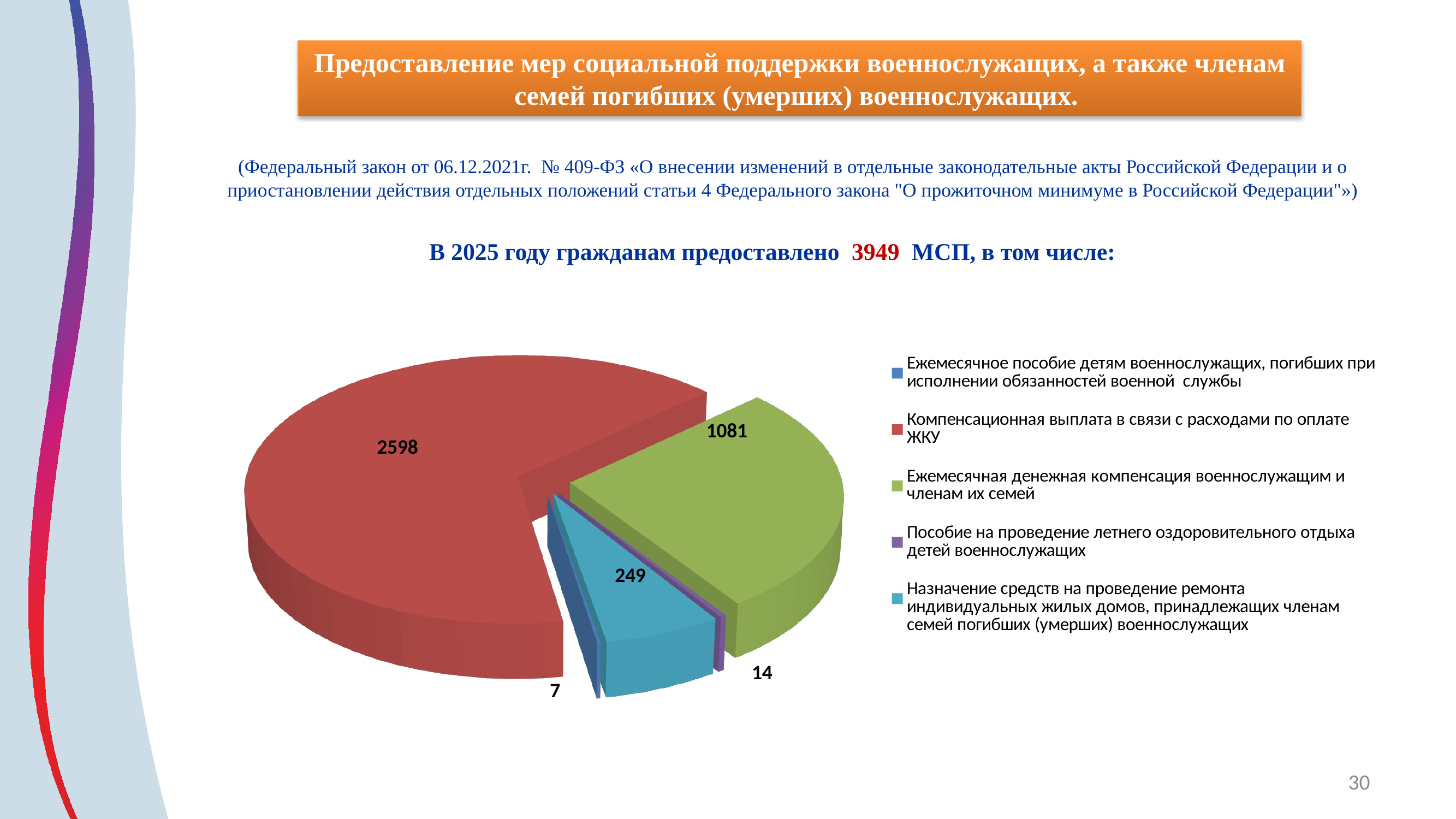
Which category has the smallest slice of the pie chart? Ежемесячное пособие детям военнослужащих, погибших при исполнении обязанностей военной службы What is the value for "Назначение средств на проведение ремонта индивидуальных жилых домов, принадлежащих членам семей погибших (умерших) военнослужащих"? 249 What is the value for "Ежемесячная денежная компенсация военнослужащим и членам их семей"? 1081 What is the difference between the values for "Компенсационная выплата в связи с расходами по оплате ЖКУ" and "Ежемесячная денежная компенсация военнослужащим и членам их семей"? 1517 Which category has the largest slice of the pie chart? Компенсационная выплата в связи с расходами по оплате ЖКУ What type of chart is shown on the slide? pie chart How many entries does the legend of the pie chart list? 5 How many slices does the pie chart have? 5 What is the value for "Компенсационная выплата в связи с расходами по оплате ЖКУ"? 2598 What is the value for "Ежемесячное пособие детям военнослужащих, погибших при исполнении обязанностей военной службы"? 7 Which colour represents "Ежемесячная денежная компенсация военнослужащим и членам их семей" in the pie chart? green What is the value for "Пособие на проведение летнего оздоровительного отдыха детей военнослужащих"? 14